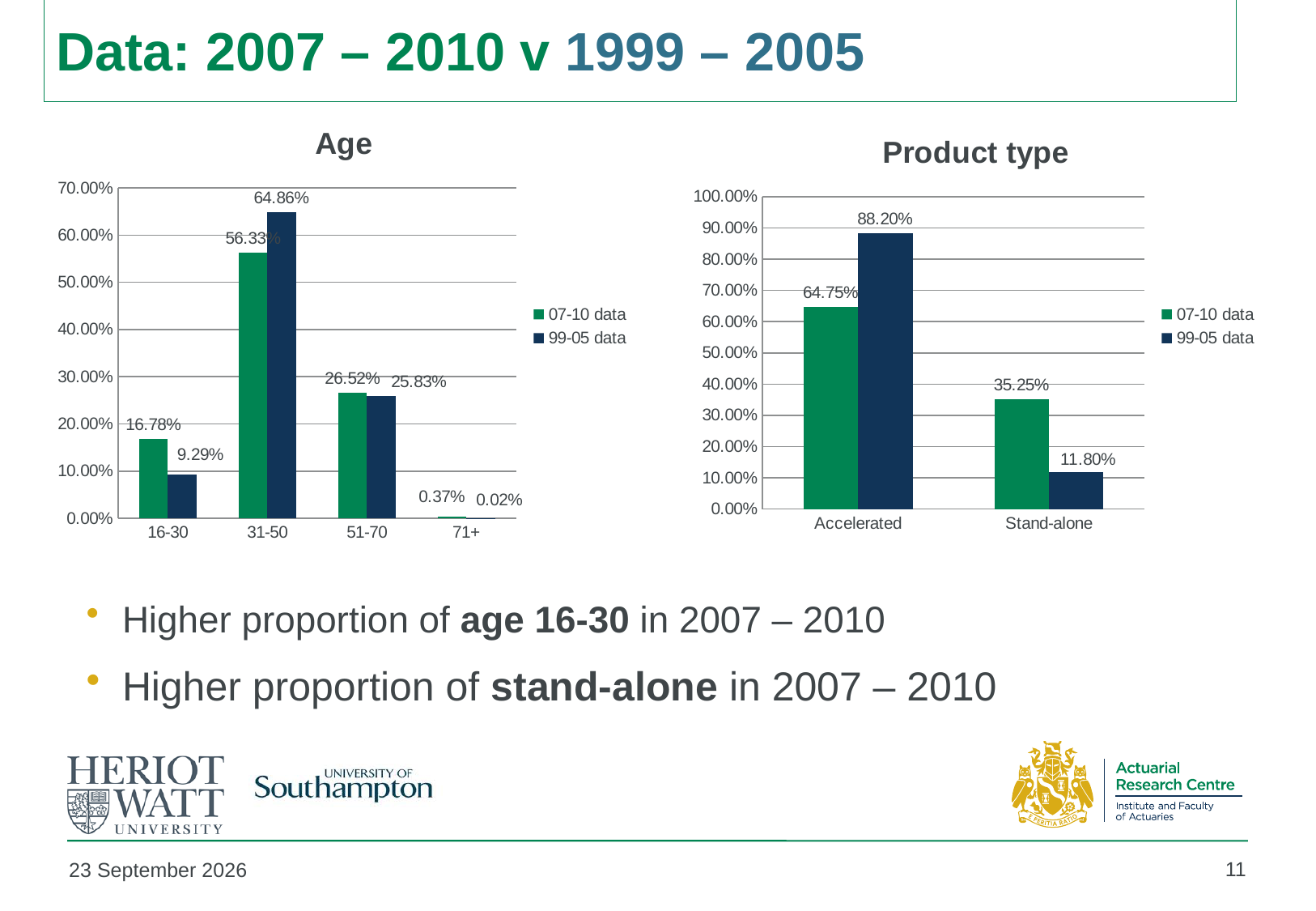
In the Age chart, which age group has the highest value in the 07-10 data series? 31-50 In the Age chart, what is the value for 16-30 in the 07-10 data series? 16.78% In the Age chart, what is the difference between the 99-05 data and 07-10 data values for 31-50? 8.53% In the Age chart, which age group has the lowest value in the 99-05 data series? 71+ What kind of chart is the Product type chart? Bar chart How many age groups are shown in the Age chart? 4 In the Age chart, what is the value for 31-50 in the 99-05 data series? 64.86% How many series does the legend of the Product type chart list? 2 In the Product type chart, what is the difference between the 07-10 data and 99-05 data values for Stand-alone? 23.45% In the Age chart, which is larger for 51-70: the 07-10 data value or the 99-05 data value? 07-10 data In the Product type chart, what is the value for Accelerated in the 07-10 data series? 64.75% In the Product type chart, what is the value for Stand-alone in the 99-05 data series? 11.80%